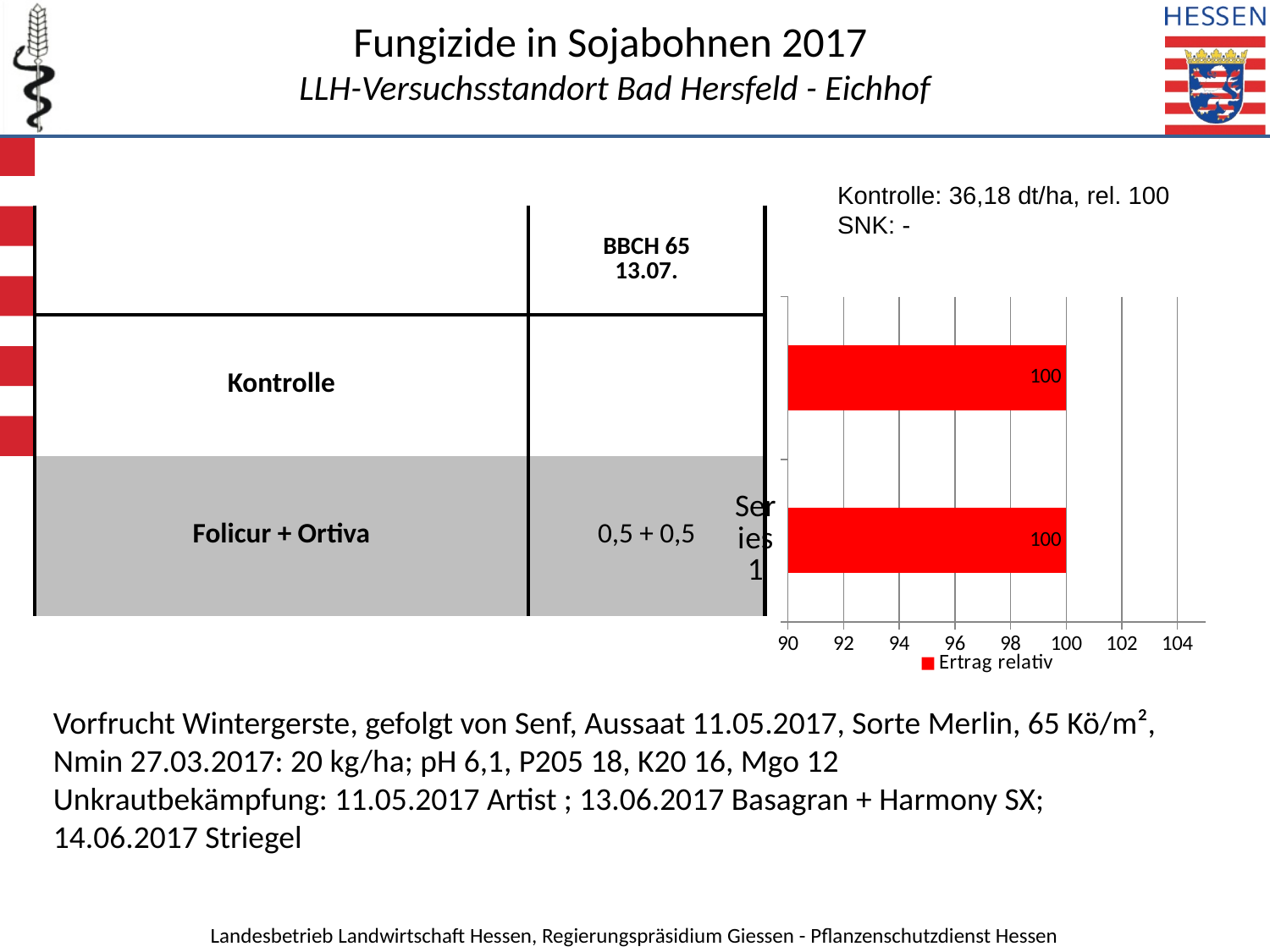
What is the relative yield (Ertrag relativ) value shown for Folicur + Ortiva? 100 What is the difference between the Ertrag relativ values for Kontrolle and Folicur + Ortiva? 0 What is the lowest value shown on the chart's horizontal axis? 90 Is the value for Kontrolle greater or less than 102? less What is the name of the series shown in the chart legend? Ertrag relativ What is the relative yield (Ertrag relativ) value shown for Kontrolle? 100 What colour are the bars in the chart? red What kind of chart is shown on the slide? bar chart How many series does the chart legend list? 1 Is the value for Folicur + Ortiva greater or less than 96? greater How many bars are plotted in the chart? 2